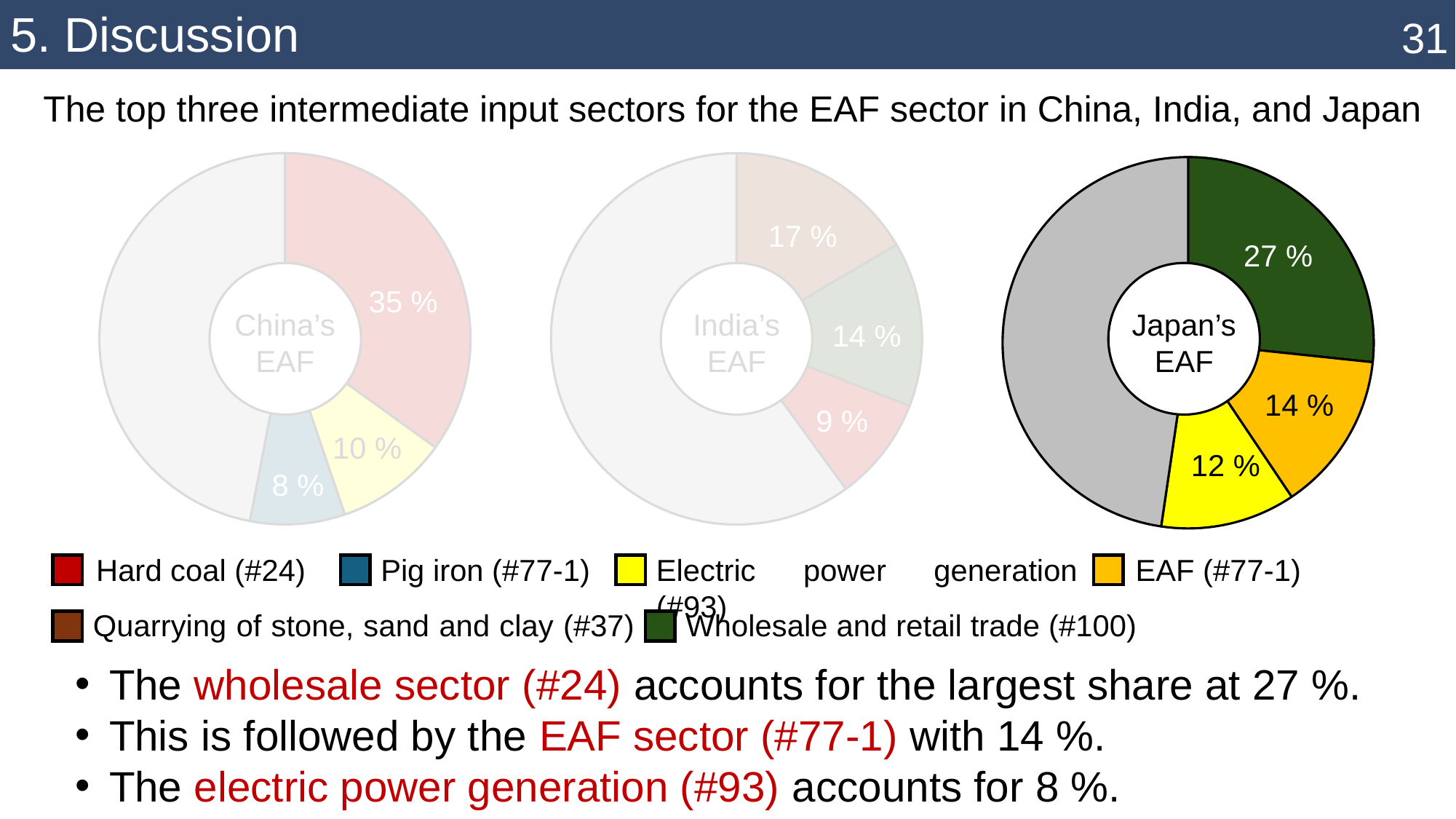
In the Japan's EAF chart, which labelled sector has the largest share? Wholesale and retail trade (#100) In the Japan's EAF chart, which labelled sector has the smallest share? Electric power generation (#93) In the Japan's EAF chart, what share is shown for Wholesale and retail trade (#100)? 27 % In the Japan's EAF chart, which is larger: the share for EAF (#77-1) or the share for Electric power generation (#93)? EAF (#77-1) How many sectors does the legend list? 6 In the China's EAF chart, what share is shown for Hard coal (#24)? 35 % How many donut charts are shown on the slide? 3 In the Japan's EAF chart, what share is shown for Electric power generation (#93)? 12 % In the India's EAF chart, what share is shown for Quarrying of stone, sand and clay (#37)? 17 % What kind of chart is used for Japan's EAF? Pie chart (donut) In the Japan's EAF chart, what share is shown for EAF (#77-1)? 14 % In the Japan's EAF chart, what is the difference between the Wholesale and retail trade share and the EAF share? 13 %